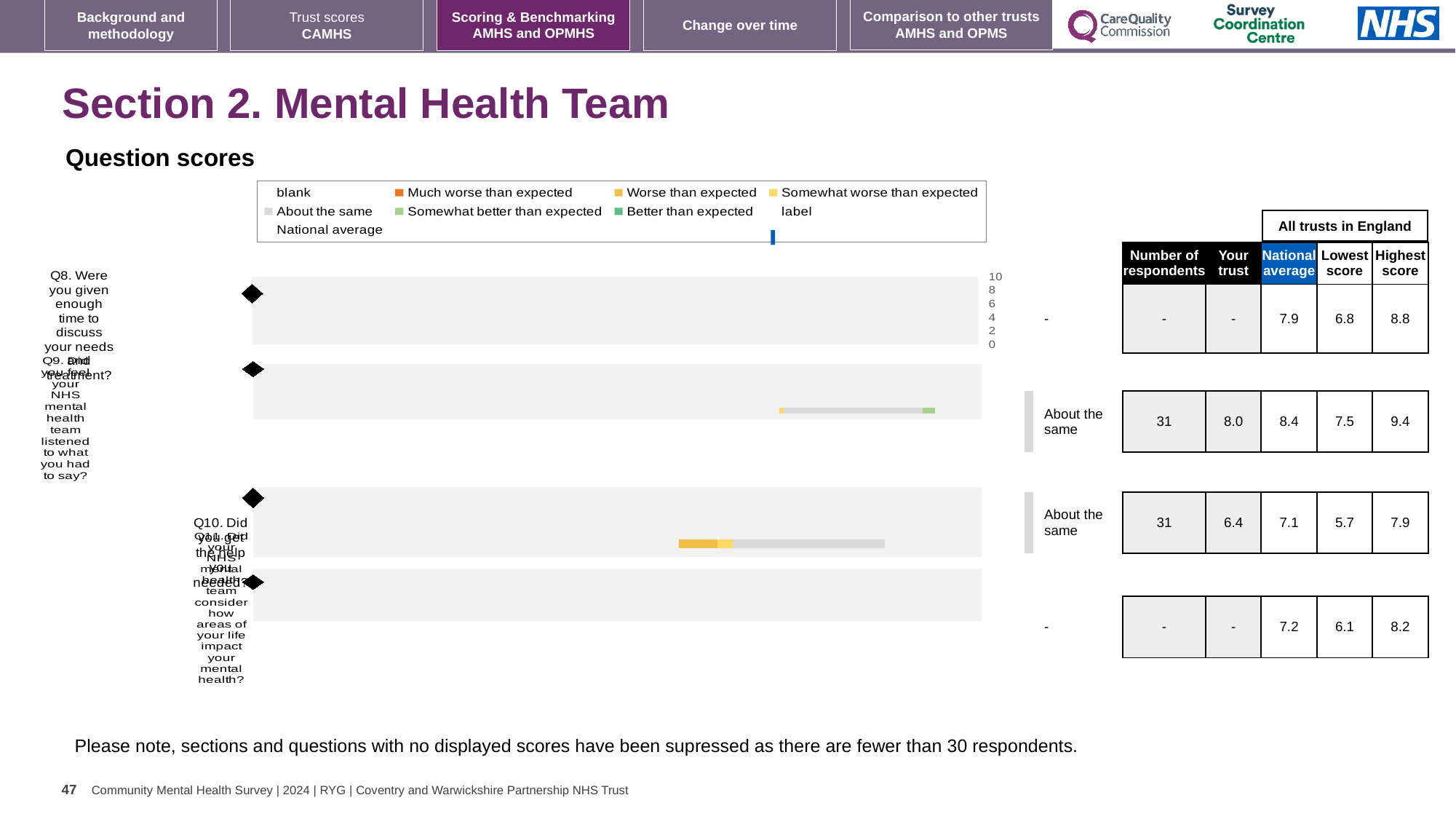
What is the 'Your trust' score for Q9 (Did you feel your NHS mental health team listened to what you had to say?)? 8.0 How many questions (Q8 to Q11) are plotted in the question scores chart? 4 What is the national average score for Q10? 7.1 What is the national average score for Q8 (Were you given enough time to discuss your needs and treatment?)? 7.9 What benchmark category is shown next to the Q10 bar? About the same What is the 'Your trust' score for Q10 (Did you get the help you needed?)? 6.4 What kind of chart is used to show the question scores on this slide? bar chart Which question has the higher 'Your trust' score, Q9 or Q10? Q9 How many respondents answered Q9? 31 What is the difference between the national average and the 'Your trust' score for Q9? 0.4 What is the national average score for Q9? 8.4 What is the highest score among all trusts in England for Q11? 8.2